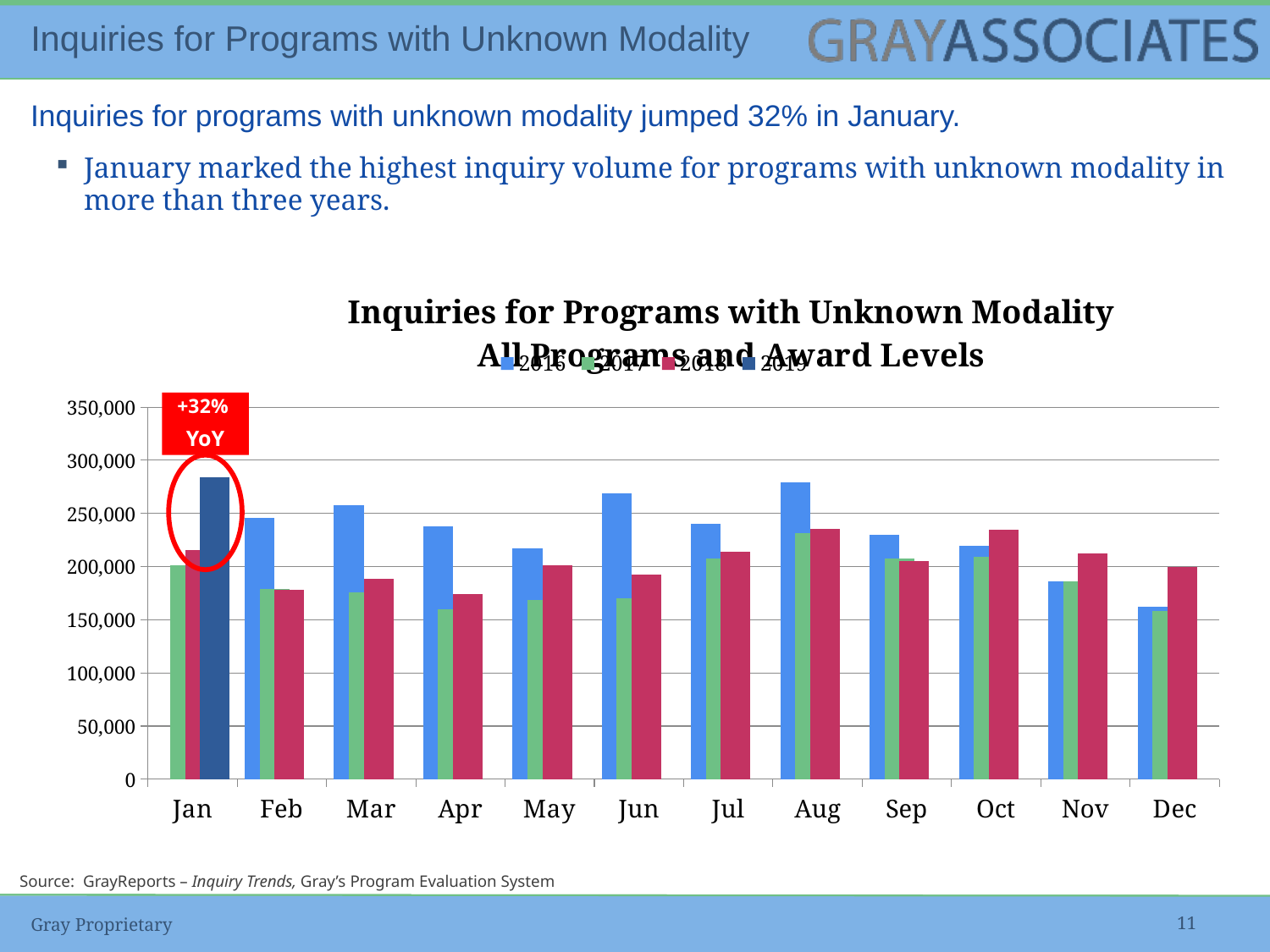
In which month is the 2016 value lowest? Dec Is the value for 2016 in Dec greater or less than 200,000? less Which years are listed in the chart legend? 2016, 2017, 2018, 2019 What year-over-year change is annotated above the January bars? +32% YoY Is the value for 2016 in Aug greater or less than 250,000? greater Do the 2016 values rise or fall from Aug to Dec? fall Is the value for 2019 in Jan greater or less than 250,000? greater In Jan, which is larger: the 2019 value or the 2018 value? 2019 What kind of chart is shown on the slide? Bar chart How many series does the chart legend list? 4 How many months are shown along the x axis of the chart? 12